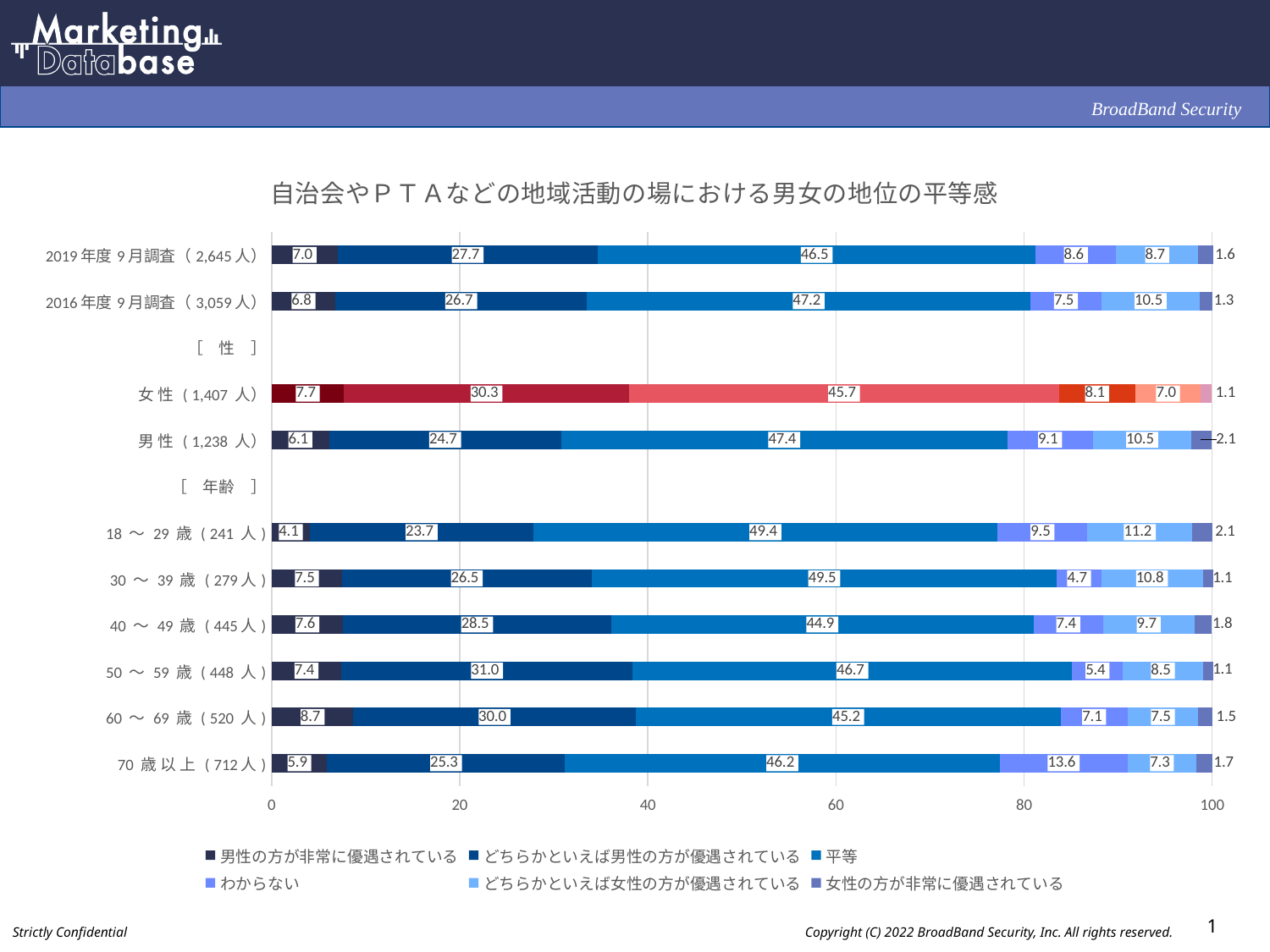
What is the value of 平等 for 2019年度 9月調査? 46.5 Is the value of 平等 for 18〜29歳 (241人) greater or less than 40? greater Which category has the highest value for 男性の方が非常に優遇されている? 60〜69歳 (520人) What is the difference in 平等 between 2016年度 9月調査 and 2019年度 9月調査? 0.7 What is the title of the chart? 自治会やＰＴＡなどの地域活動の場における男女の地位の平等感 What kind of chart is shown on the slide? Stacked horizontal bar chart Which has the larger value for 平等, 女性 (1,407人) or 男性 (1,238人)? 男性 (1,238人) Which category has the lowest value for 男性の方が非常に優遇されている? 18〜29歳 (241人) How many series does the legend list? 6 How many bars with data are plotted in the chart? 10 What is the value of 男性の方が非常に優遇されている for 70歳以上 (712人)? 5.9 What is the value of どちらかといえば男性の方が優遇されている for 女性 (1,407人)? 30.3